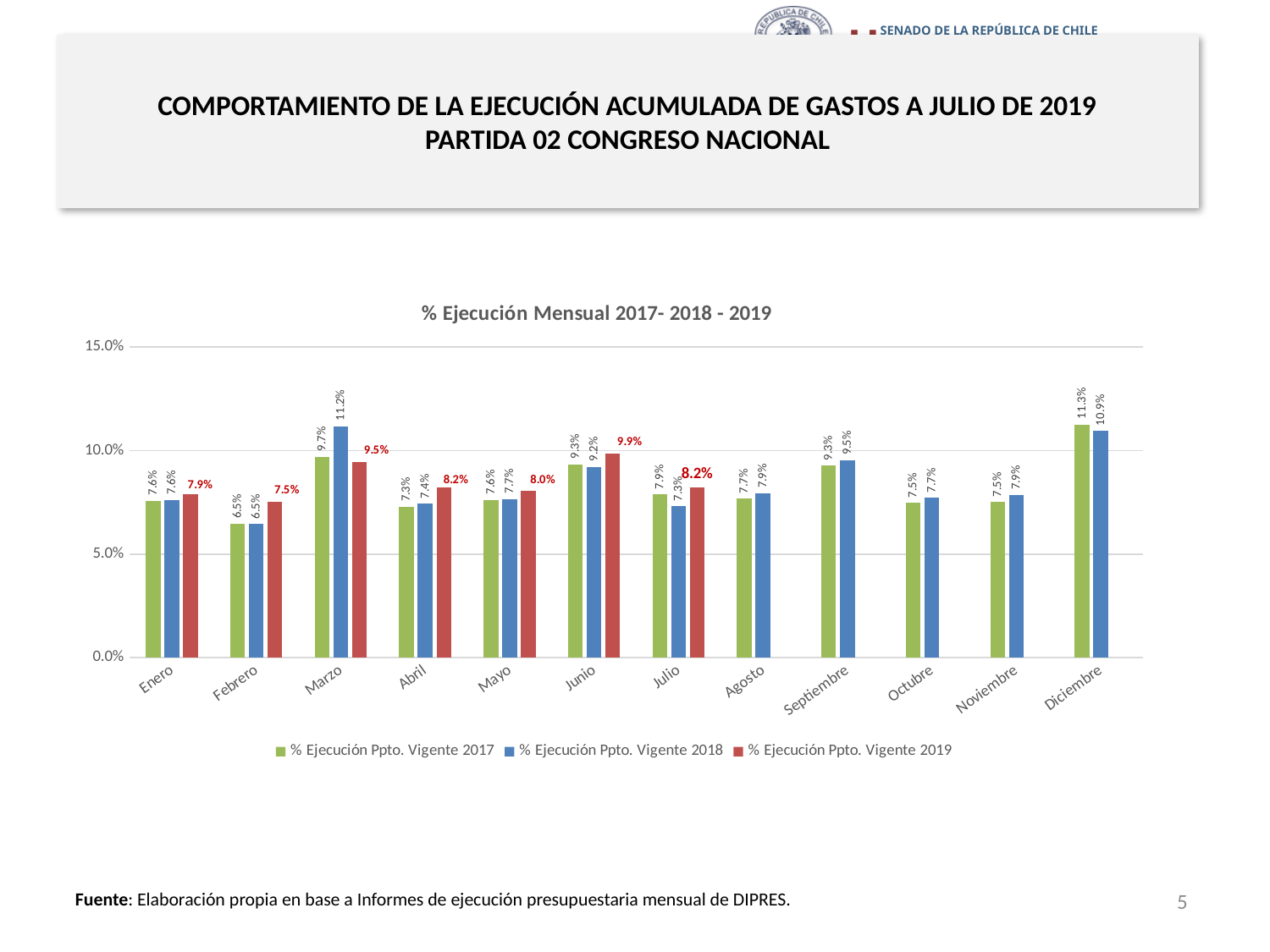
Is the value for % Ejecución Ppto. Vigente 2018 in Diciembre greater or less than 10.0%? greater What type of chart is shown on the slide? Bar chart What is the difference between the 2018 and 2019 values in Marzo? 1.7% What is the value for % Ejecución Ppto. Vigente 2017 in Diciembre? 11.3% How many months have a value plotted for % Ejecución Ppto. Vigente 2019? 7 What is the value for % Ejecución Ppto. Vigente 2019 in Febrero? 7.5% Which is larger in Julio: the 2017 value or the 2018 value? 2017 value (7.9%) What is the value for % Ejecución Ppto. Vigente 2019 in Junio? 9.9% What is the value for % Ejecución Ppto. Vigente 2018 in Marzo? 11.2% In which month is the % Ejecución Ppto. Vigente 2017 series highest? Diciembre In which month is the % Ejecución Ppto. Vigente 2018 series lowest? Febrero How many series does the legend list? 3